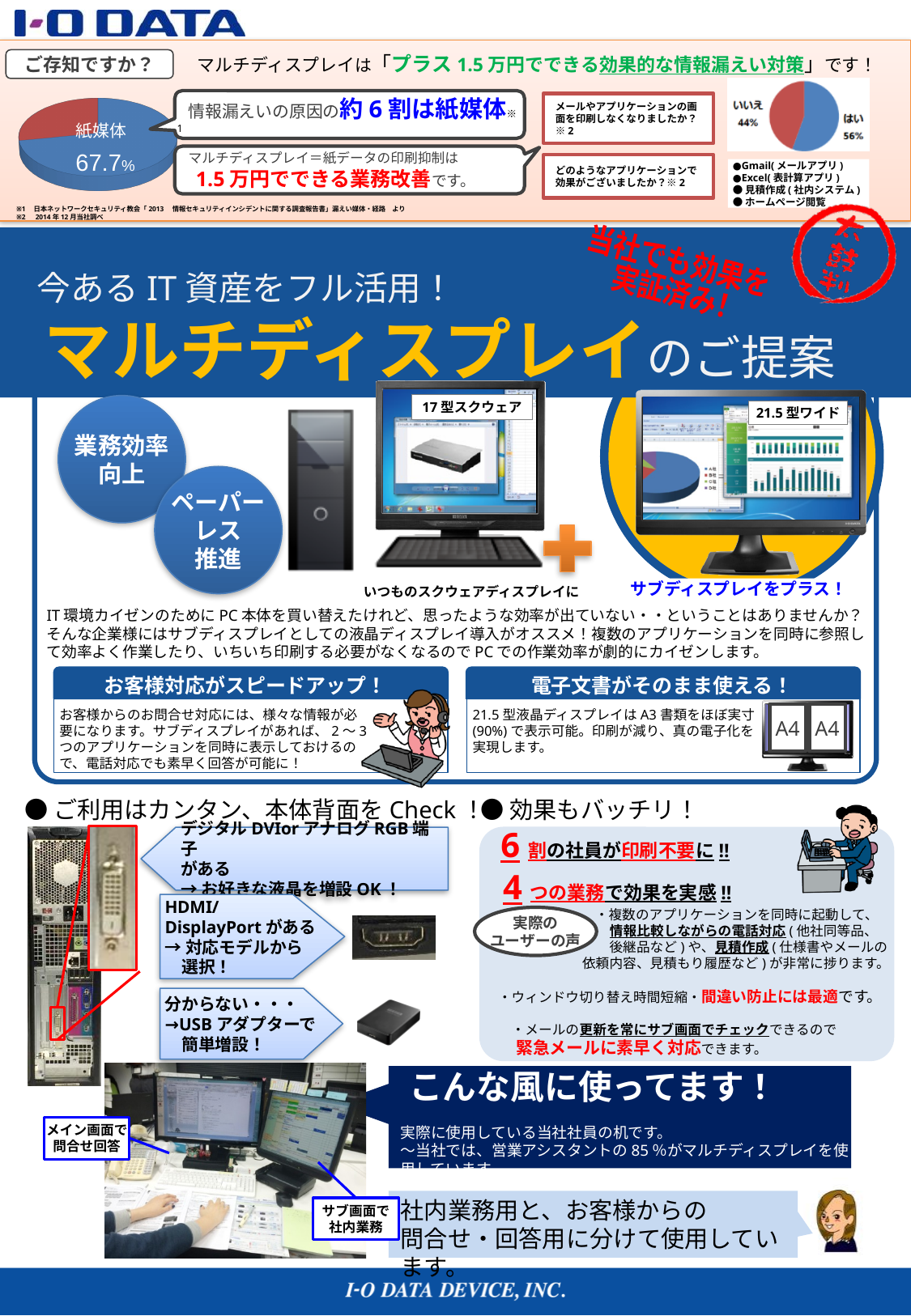
In the pie chart at the top left of the slide, what percentage is shown for 紙媒体? 67.7% In the pie chart at the top right of the slide, which slice is larger, はい or いいえ? はい What kind of chart is the chart at the top left of the slide showing 紙媒体? pie chart How many slices does the pie chart at the top right of the slide have? 2 In the pie chart at the top left of the slide, is the value for 紙媒体 greater or less than 50%? greater In the pie chart at the top right of the slide, is the value for いいえ greater or less than 50%? less In the pie chart at the top right of the slide, what is the difference between the はい and いいえ percentages? 12% In the pie chart at the top right of the slide, which slice is the largest? はい In the pie chart at the top right of the slide, what colour is the いいえ slice? red In the pie chart at the top right of the slide, what percentage is shown for はい? 56% What kind of chart is the chart at the top right of the slide showing はい and いいえ? pie chart In the pie chart at the top right of the slide, what percentage is shown for いいえ? 44%